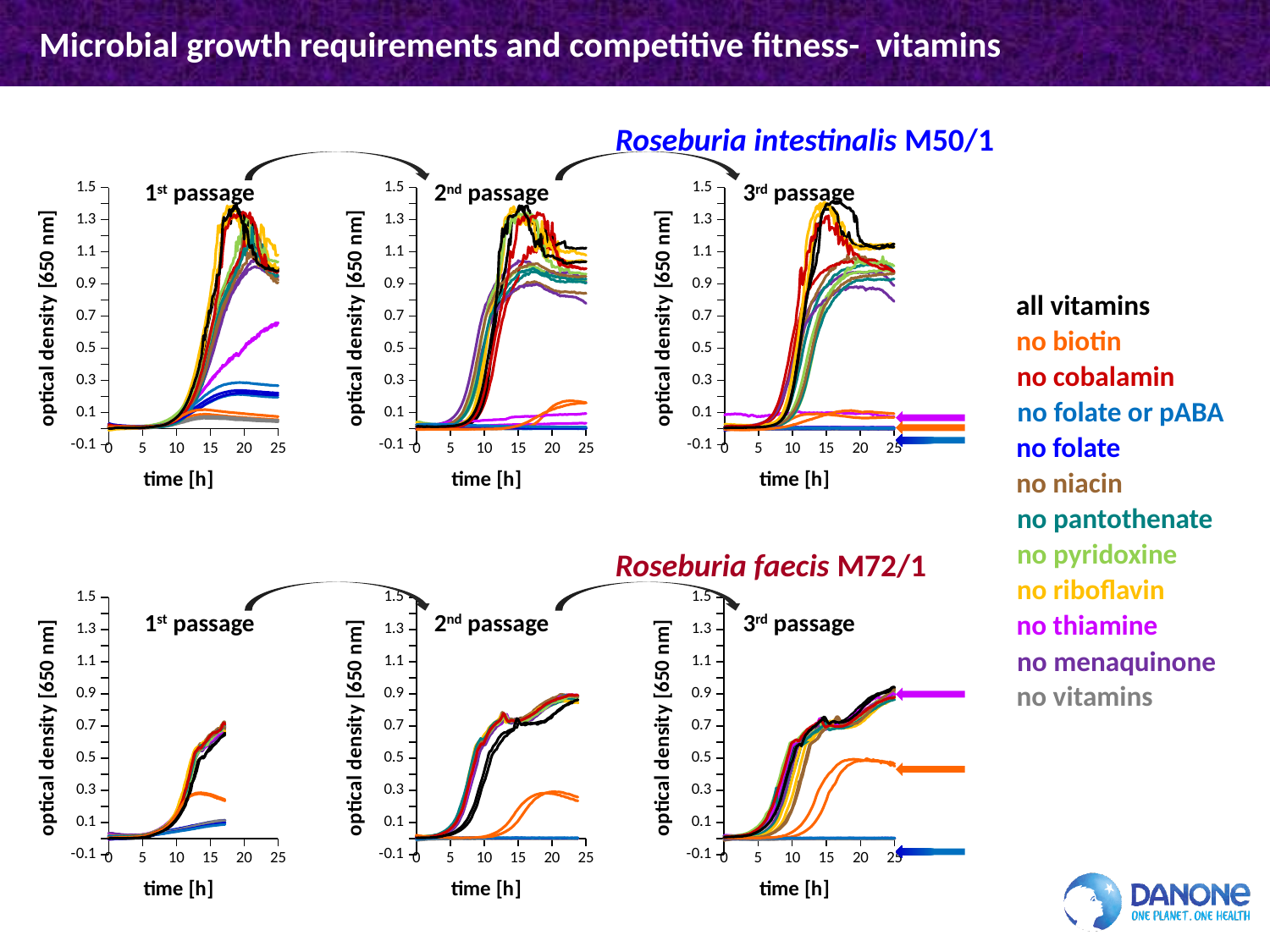
In the Roseburia faecis M72/1 3rd passage chart, which curve is higher at 20 h: 'no biotin' or 'no folate'? no biotin In the Roseburia faecis M72/1 3rd passage chart, is the value of the 'no biotin' curve at 20 h greater or less than 0.7? less In the Roseburia intestinalis M50/1 1st passage chart, is the peak value of the 'all vitamins' curve greater or less than 1.1? greater What is the y-axis label of the Roseburia faecis M72/1 2nd passage chart? optical density [650 nm] In the Roseburia faecis M72/1 3rd passage chart, is the value of the 'no biotin' curve at 20 h greater or less than 0.3? greater What kind of chart is used for the Roseburia intestinalis M50/1 1st passage panel? line chart In the Roseburia faecis M72/1 1st passage chart, does the 'all vitamins' curve rise or fall between 5 h and 15 h? rise In the Roseburia intestinalis M50/1 1st passage chart, which curve is higher at 20 h: 'no thiamine' or 'no folate'? no thiamine How many growth-curve charts are shown on the slide? 6 What is the x-axis label of the Roseburia intestinalis M50/1 3rd passage chart? time [h] How many series does the legend on the right of the slide list? 12